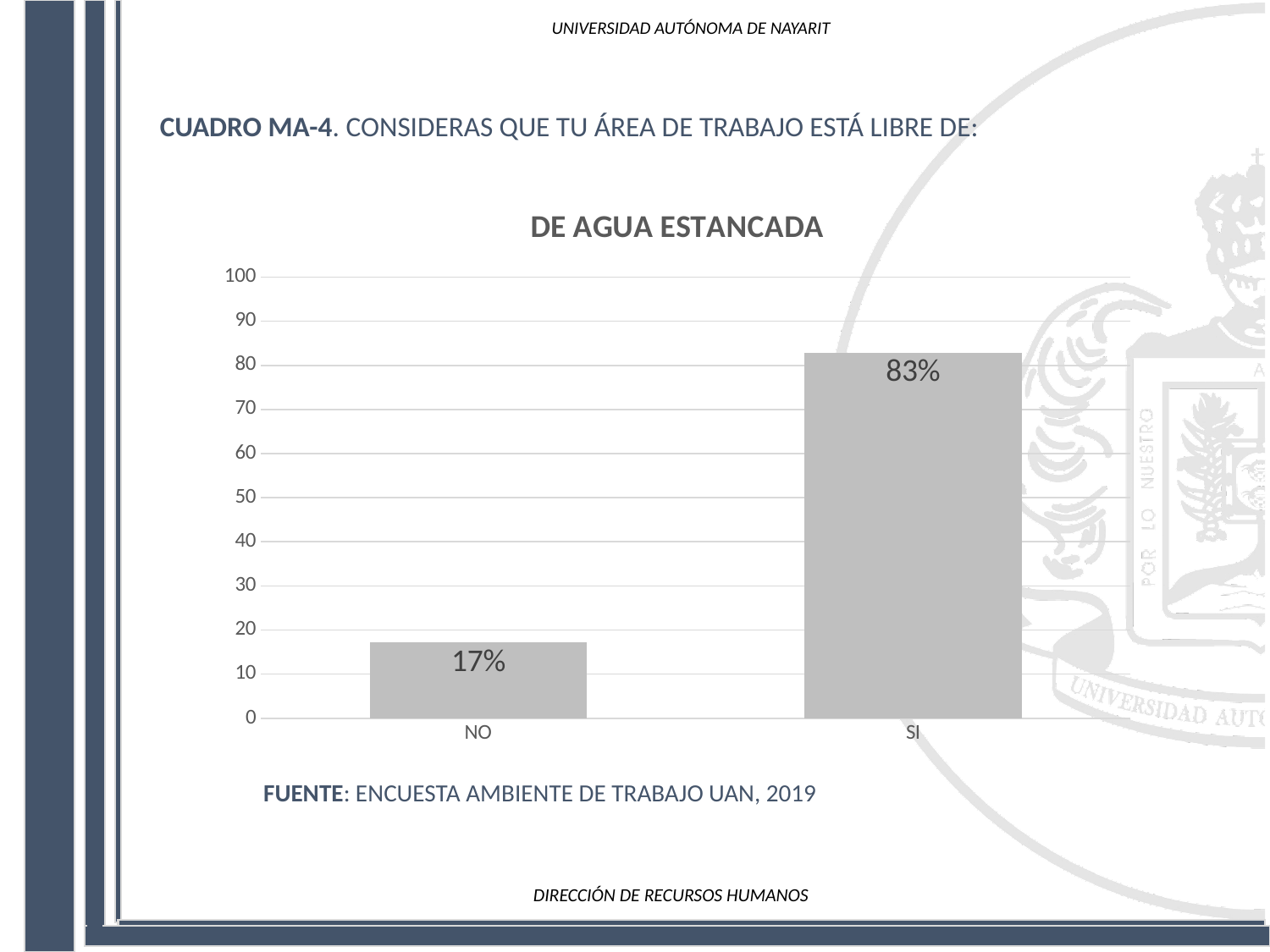
Which category has the highest value? SI What is the maximum value shown on the y axis? 100 What is the difference between the values for SI and NO? 66% What is the value for NO? 17% Which category has the lowest value? NO What is the value for SI? 83% Is the value for NO greater or less than 20? less How many categories are shown on the x axis? 2 Which is larger, the value for NO or the value for SI? SI What is the title of the chart? DE AGUA ESTANCADA What kind of chart is shown? bar chart Is the value for SI greater or less than 80? greater